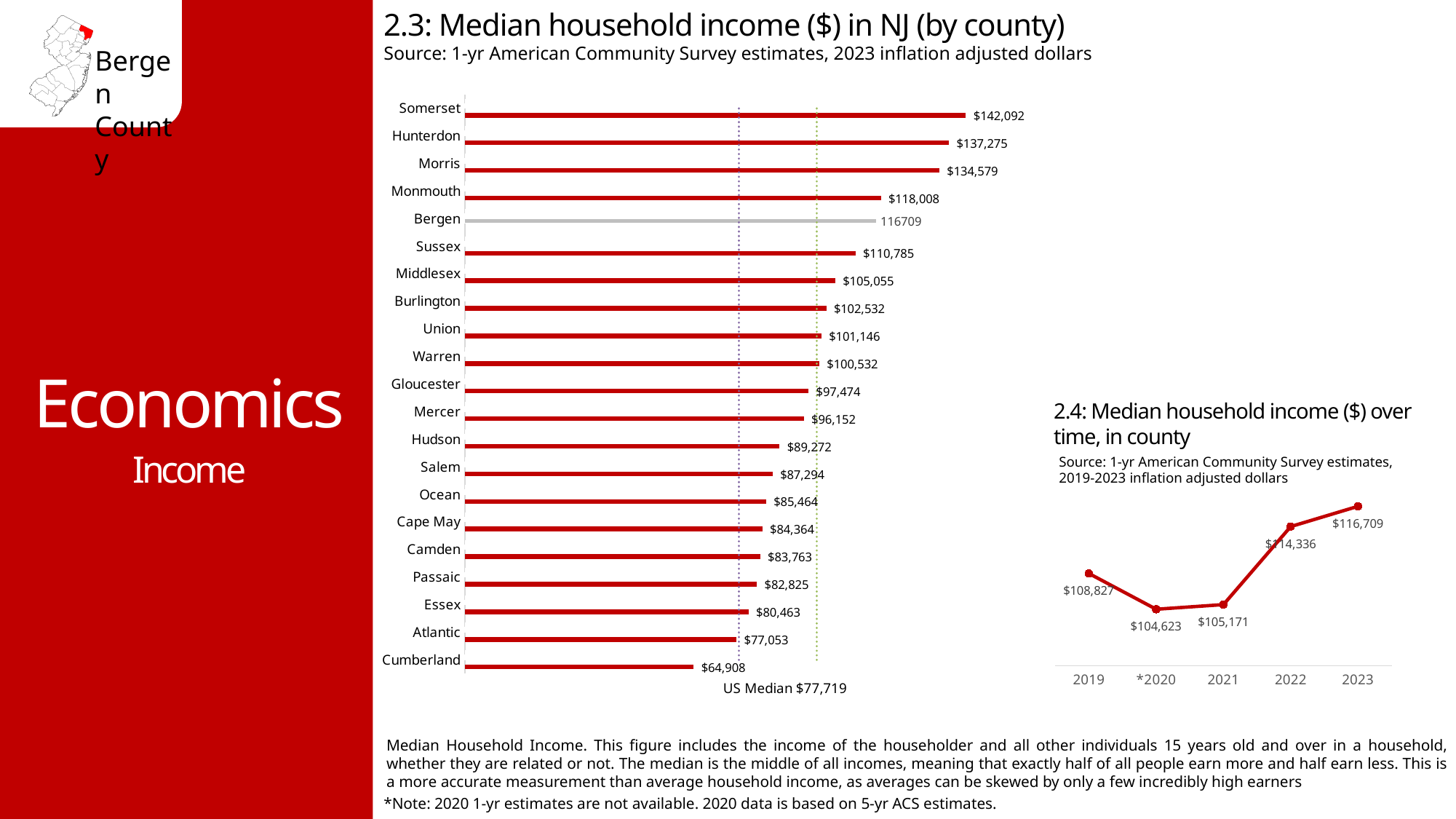
In chart 2.3 (Median household income in NJ by county), what is the value shown for Bergen? 116709 In chart 2.3 (Median household income in NJ by county), what is the median household income for Somerset? $142,092 In chart 2.4 (Median household income over time, in county), what is the value for 2023? $116,709 What kind of chart is chart 2.4 (Median household income over time, in county)? Line chart In chart 2.4 (Median household income over time, in county), what is the difference between the 2023 and 2019 values? $7,882 In chart 2.4 (Median household income over time, in county), which year has the lowest median household income? *2020 What kind of chart is chart 2.3 (Median household income in NJ by county)? Bar chart In chart 2.3 (Median household income in NJ by county), which county has the lowest median household income? Cumberland In chart 2.3 (Median household income in NJ by county), which has a higher median household income, Hudson or Mercer? Mercer In chart 2.3 (Median household income in NJ by county), how many counties are plotted? 21 In chart 2.3 (Median household income in NJ by county), what is the difference between Somerset's and Cumberland's median household income? $77,184 In chart 2.3 (Median household income in NJ by county), which county has the highest median household income? Somerset